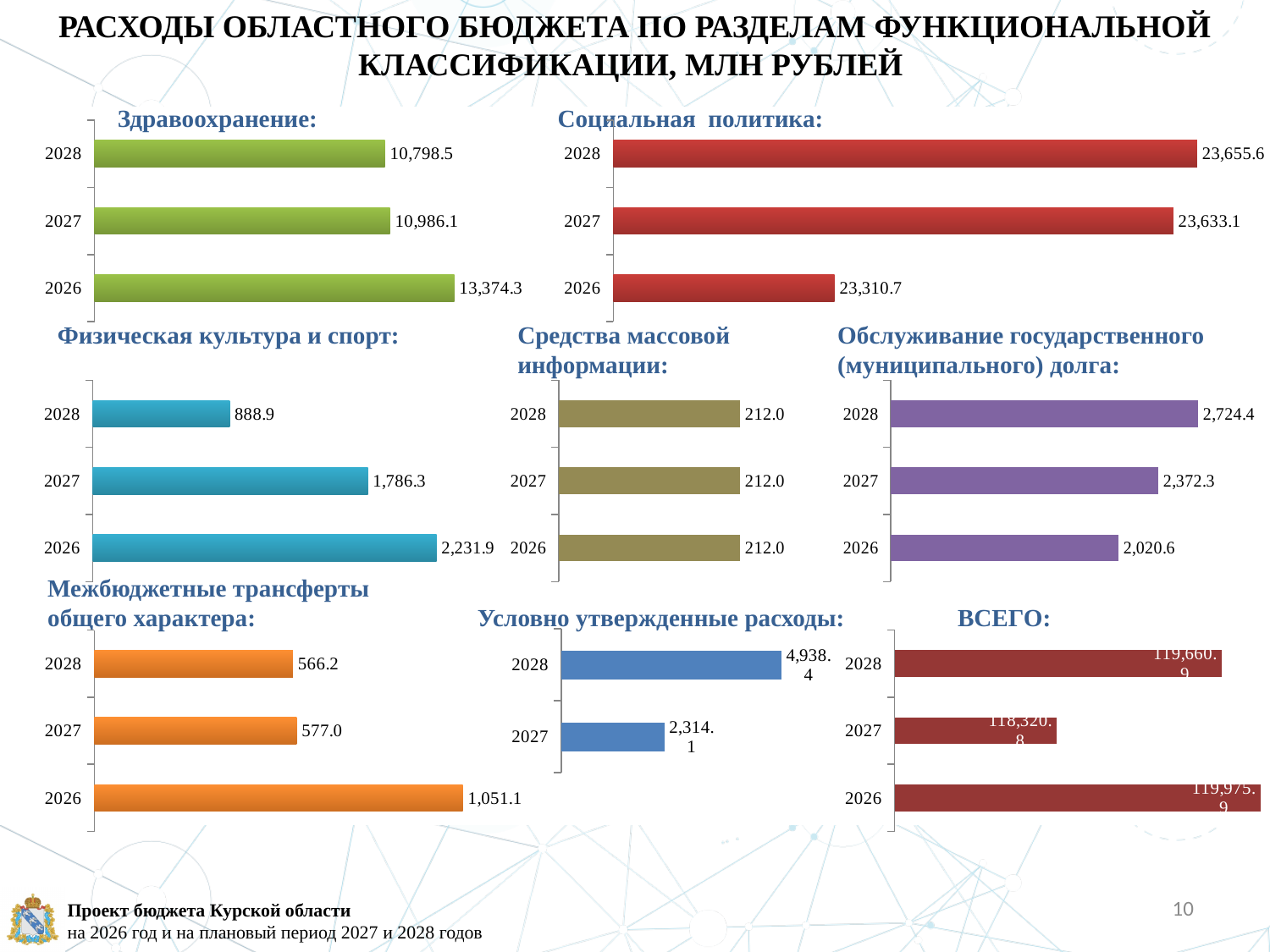
In the Физическая культура и спорт chart, what is the difference between the 2026 and 2028 values? 1,343.0 What kind of chart is the Социальная политика chart? bar chart In the Средства массовой информации chart, what is the value for 2027? 212.0 In the Социальная политика chart, which year has the highest value? 2028 In the Межбюджетные трансферты общего характера chart, which year has the lowest value? 2028 In the Условно утвержденные расходы chart, what is the value for 2028? 4,938.4 How many bars are in the Межбюджетные трансферты общего характера chart? 3 How many bars are in the Условно утвержденные расходы chart? 2 In the Здравоохранение chart, which is larger, the value for 2027 or for 2028? 2027 In the Здравоохранение chart, what is the value for 2026? 13,374.3 In the Обслуживание государственного (муниципального) долга chart, do the values rise or fall from 2026 to 2028? rise In the Обслуживание государственного (муниципального) долга chart, what is the difference between the 2028 and 2026 values? 703.8